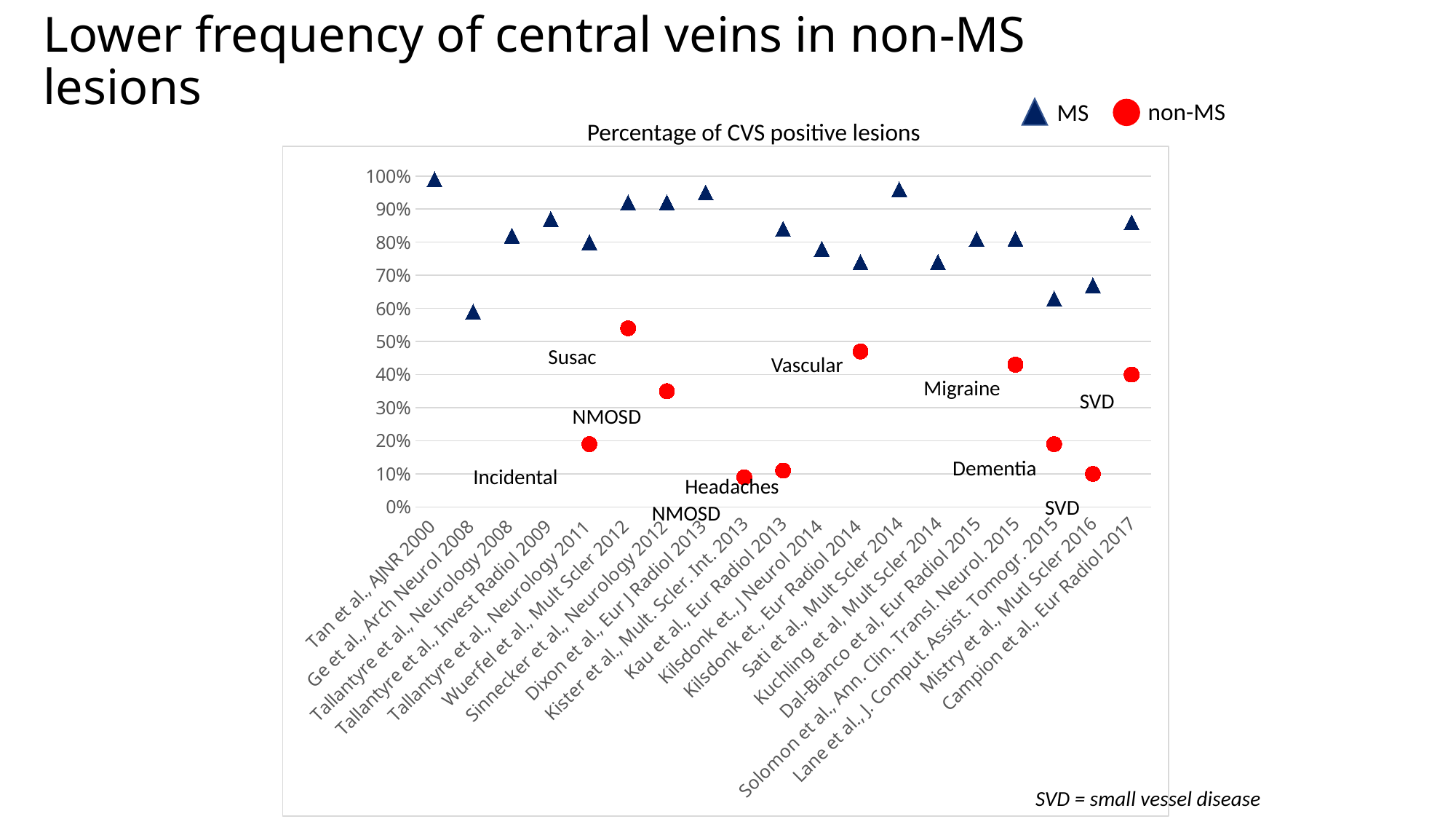
Is the non-MS value for Kilsdonk et., Eur Radiol 2014 greater or less than 60%? less How many series does the legend list? 2 What kind of chart is shown on the slide? Scatter chart Which study has the highest MS value? Tan et al., AJNR 2000 Is the non-MS value for Tallantyre et al., Neurology 2011 greater or less than 30%? less Is the MS value for Ge et al., Arch Neurol 2008 greater or less than 70%? less What does the abbreviation SVD stand for according to the note on the chart? small vessel disease Which study has the highest non-MS value? Wuerfel et al., Mult Scler 2012 For Tallantyre et al., Neurology 2011, which is larger: the MS value or the non-MS value? MS How many studies are listed along the x axis? 19 What is the title of the chart? Percentage of CVS positive lesions